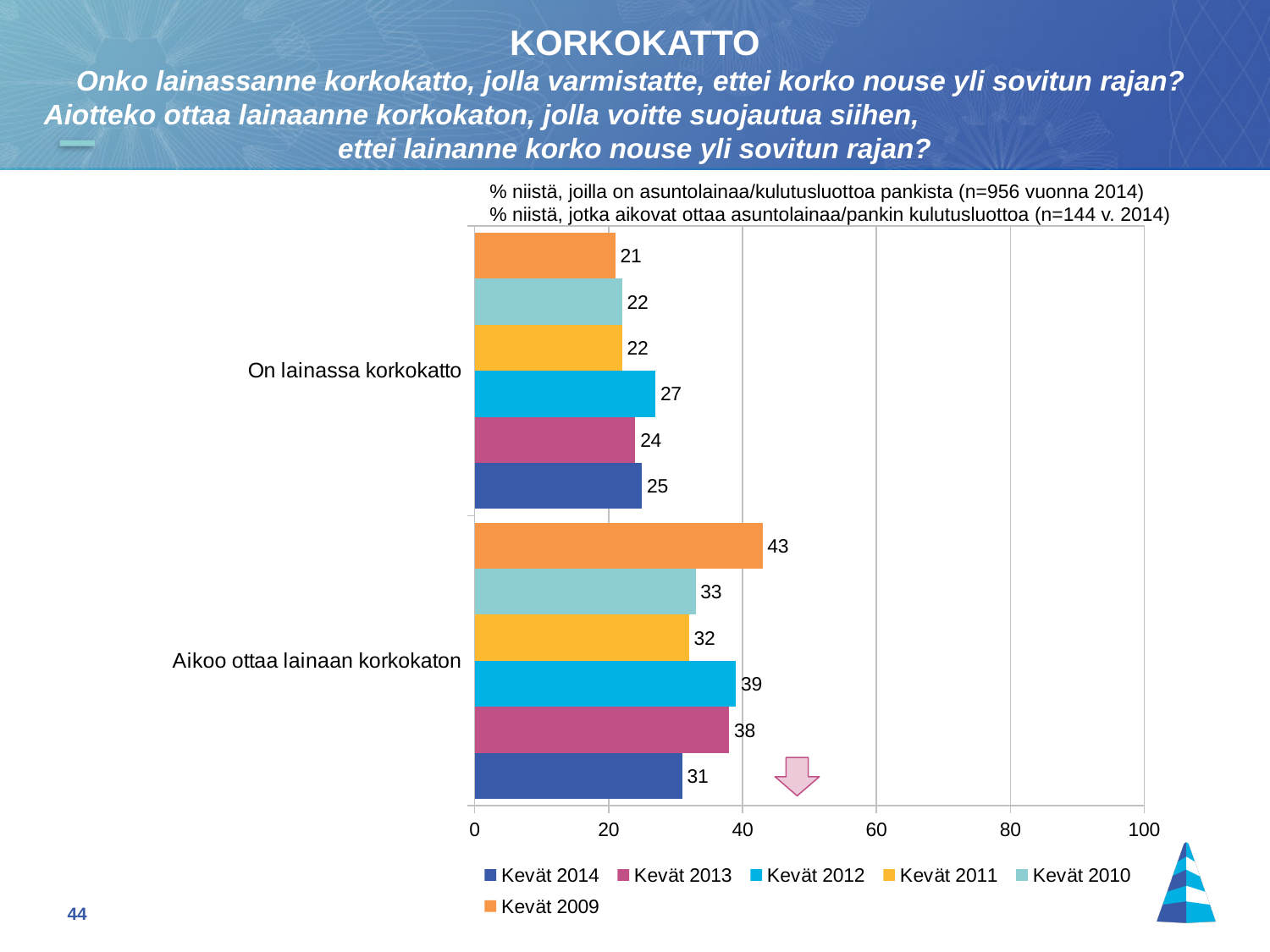
Which series has the lowest value in the category 'On lainassa korkokatto'? Kevät 2009 Which series has the highest value in the category 'Aikoo ottaa lainaan korkokaton'? Kevät 2009 In the category 'Aikoo ottaa lainaan korkokaton', which is larger: the value for Kevät 2012 or Kevät 2013? Kevät 2012 What is the value for Kevät 2009 in the category 'Aikoo ottaa lainaan korkokaton'? 43 What is the value for Kevät 2014 in the category 'On lainassa korkokatto'? 25 What is the value for Kevät 2012 in the category 'On lainassa korkokatto'? 27 Is the value for Kevät 2009 in the category 'Aikoo ottaa lainaan korkokaton' greater or less than 40? greater How many categories are shown on the chart? 2 What is the value for Kevät 2013 in the category 'On lainassa korkokatto'? 24 How many series does the legend list? 6 What is the difference between the Kevät 2009 and Kevät 2014 values in the category 'Aikoo ottaa lainaan korkokaton'? 12 What kind of chart is shown on the slide? bar chart